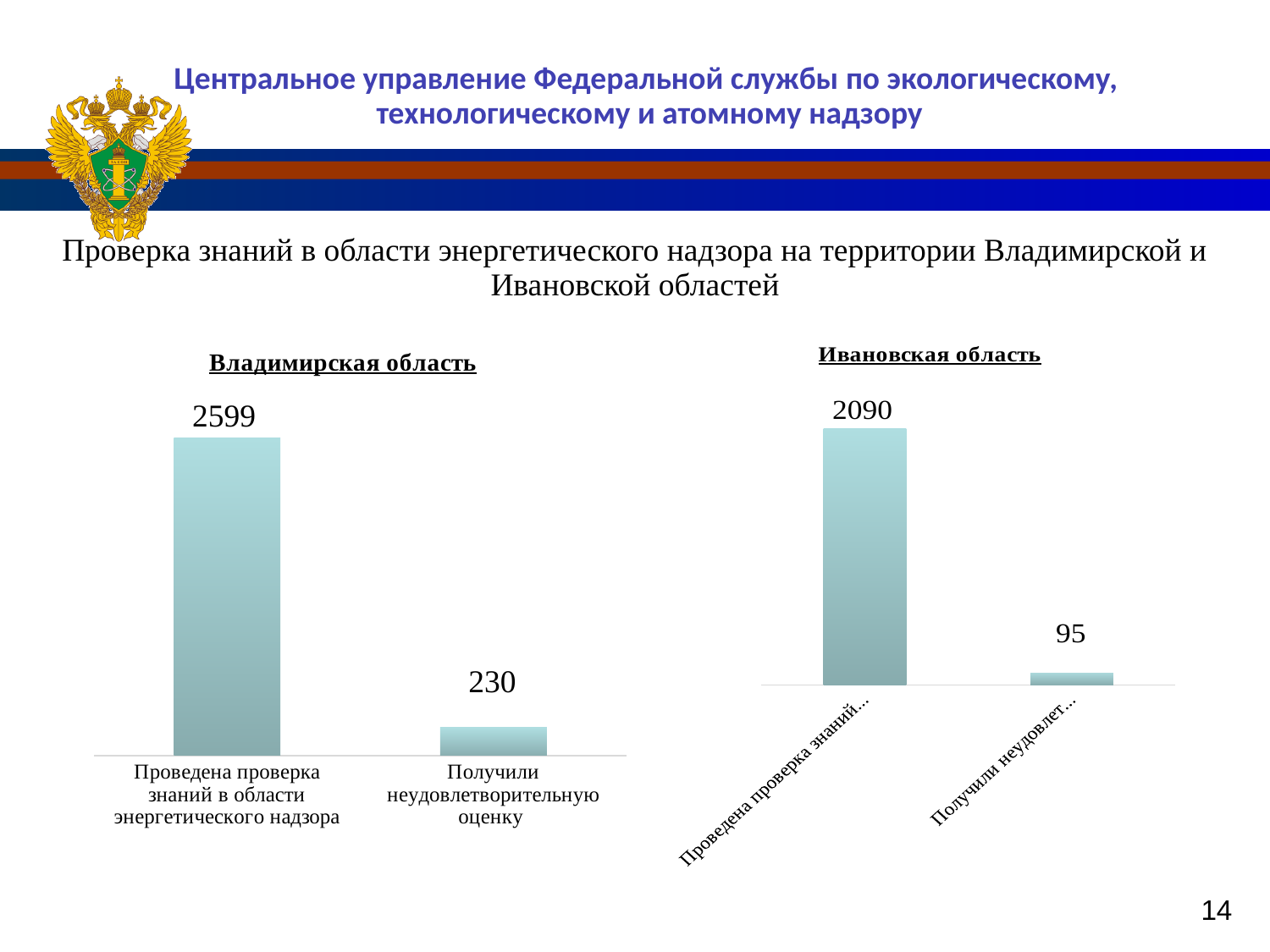
Which is larger: the first bar in the 'Владимирская область' chart or the first bar in the 'Ивановская область' chart? Владимирская область (2599) What is the title of the chart on the left side of the slide? Владимирская область In the 'Владимирская область' chart, what is the value for 'Получили неудовлетворительную оценку'? 230 In the 'Ивановская область' chart, what is the difference between the two bars? 1995 How many bars does the 'Владимирская область' chart have? 2 In the 'Ивановская область' chart, which bar has the lowest value? Получили неудовлет... In the 'Владимирская область' chart, what is the value for 'Проведена проверка знаний в области энергетического надзора'? 2599 In the 'Владимирская область' chart, which category has the highest value? Проведена проверка знаний в области энергетического надзора In the 'Ивановская область' chart, what is the value of the second bar (Получили неудовлет...)? 95 What type of chart is the 'Ивановская область' chart? Bar chart In the 'Владимирская область' chart, what is the difference between the two bars? 2369 In the 'Ивановская область' chart, what is the value of the first bar (Проведена проверка знаний...)? 2090